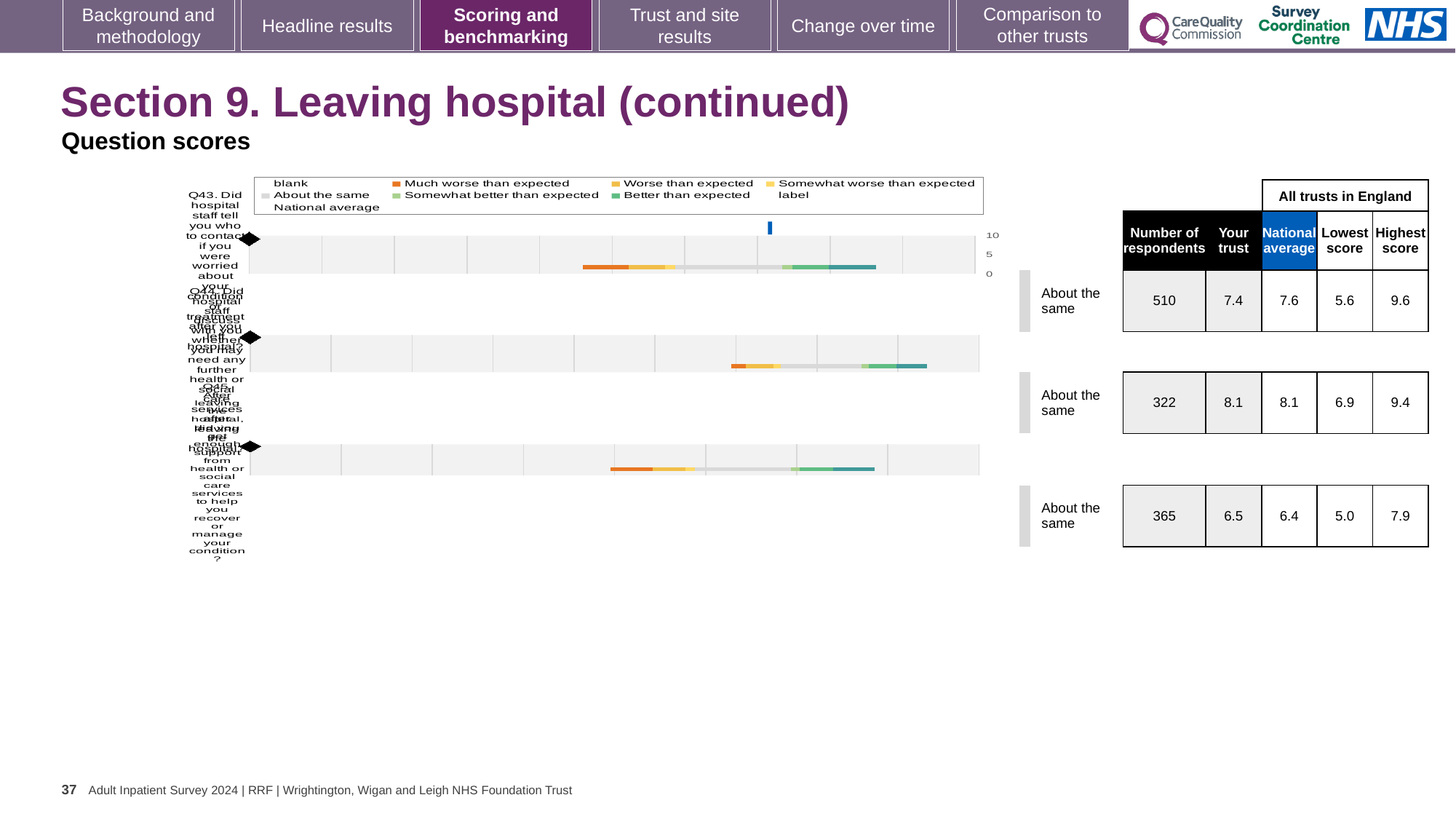
What kind of chart is shown on the slide? bar chart How many question bars are plotted in the chart? 3 What is the question number of the last (bottom) bar in the chart? Q45 Which legend entry is shown in orange? Much worse than expected What is the question number of the first (top) bar in the chart? Q43 What is the highest value shown on the chart's axis? 10